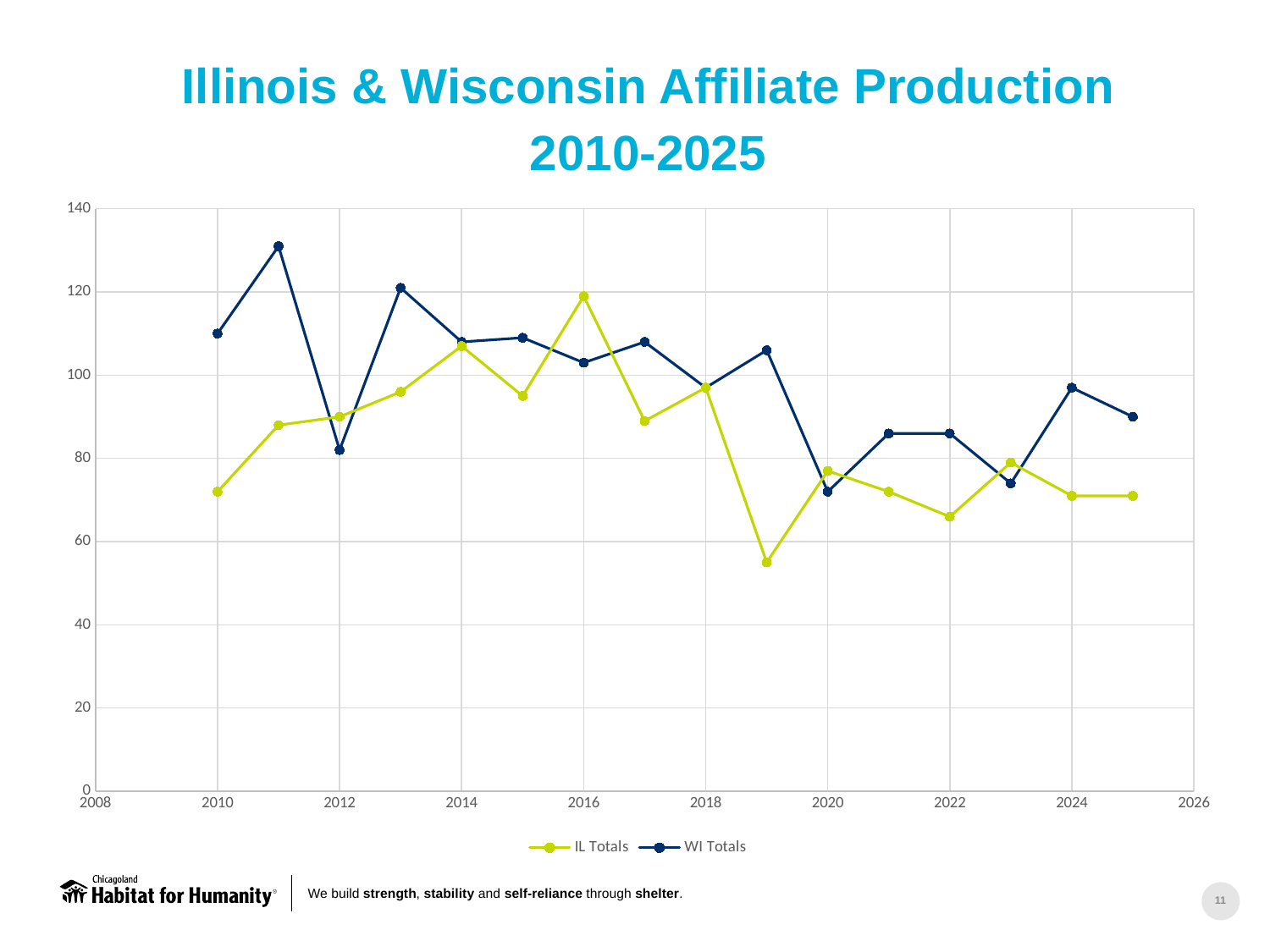
In which year does the IL Totals series reach its highest value? 2016 What kind of chart is shown on the slide? line chart Does the IL Totals series rise or fall from 2016 to 2019? fall In which year does the IL Totals series reach its lowest value? 2019 How many years of data points are plotted for each series? 16 In 2016, which series has the larger value, IL Totals or WI Totals? IL Totals Is the value for IL Totals in 2019 greater or less than 60? less How many series does the legend list? 2 In which year does the WI Totals series reach its highest value? 2011 Is the value for WI Totals in 2011 greater or less than 120? greater Is the value for IL Totals in 2010 greater or less than 80? less What are the two series named in the legend? IL Totals and WI Totals